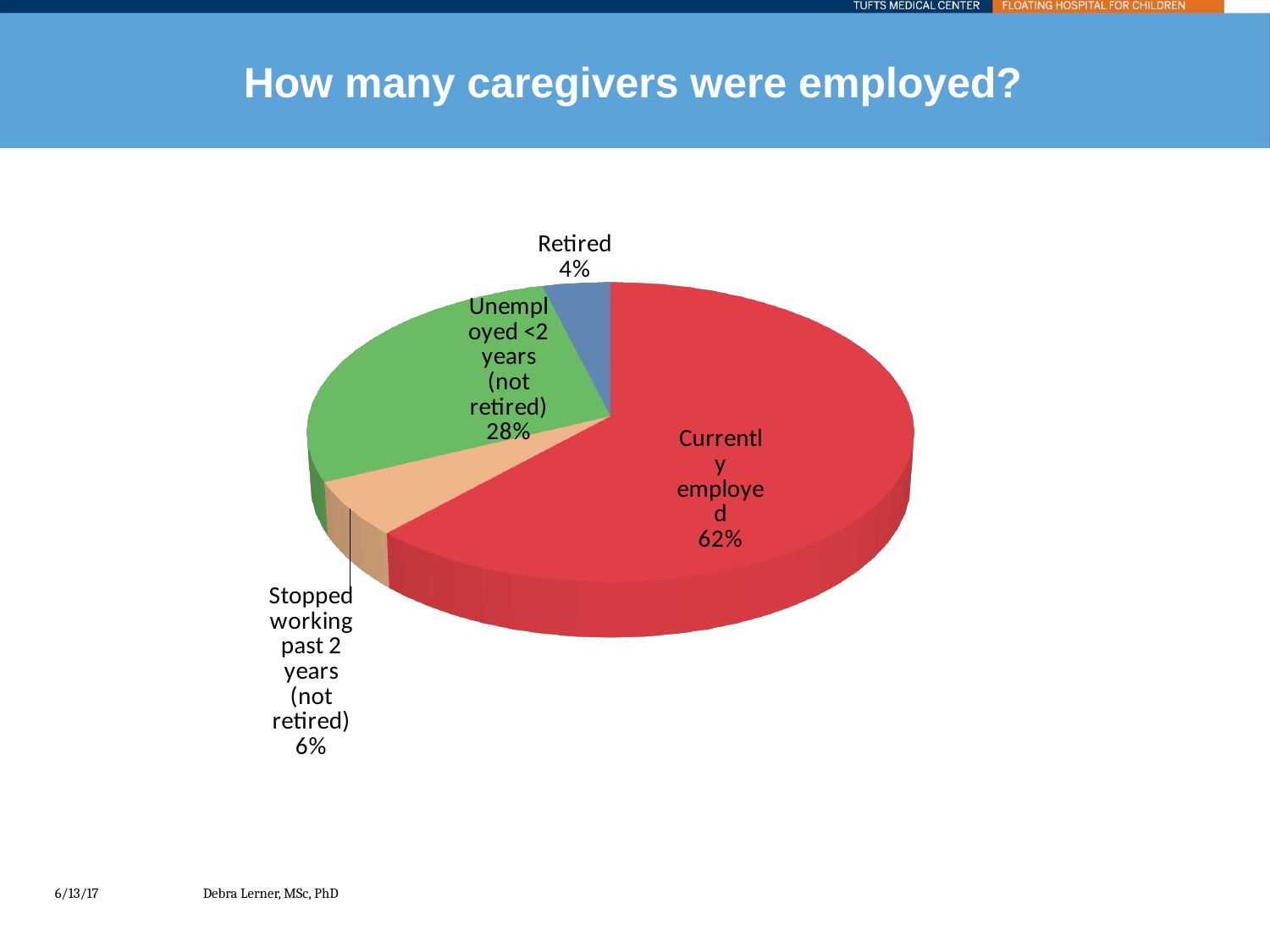
Which category has the smallest slice of the pie? Retired Which is larger: the share for retired or the share for stopped working past 2 years (not retired)? Stopped working past 2 years (not retired) What share of caregivers were retired? 4% What is the difference in percentage points between currently employed and unemployed <2 years (not retired)? 34 What share of caregivers were unemployed <2 years (not retired)? 28% What colour is the slice for currently employed? Red What share of caregivers stopped working past 2 years (not retired)? 6% What kind of chart is shown on the slide? Pie chart How many categories are shown in the pie chart? 4 Which category has the largest slice of the pie? Currently employed What is the title of the slide containing the chart? How many caregivers were employed?